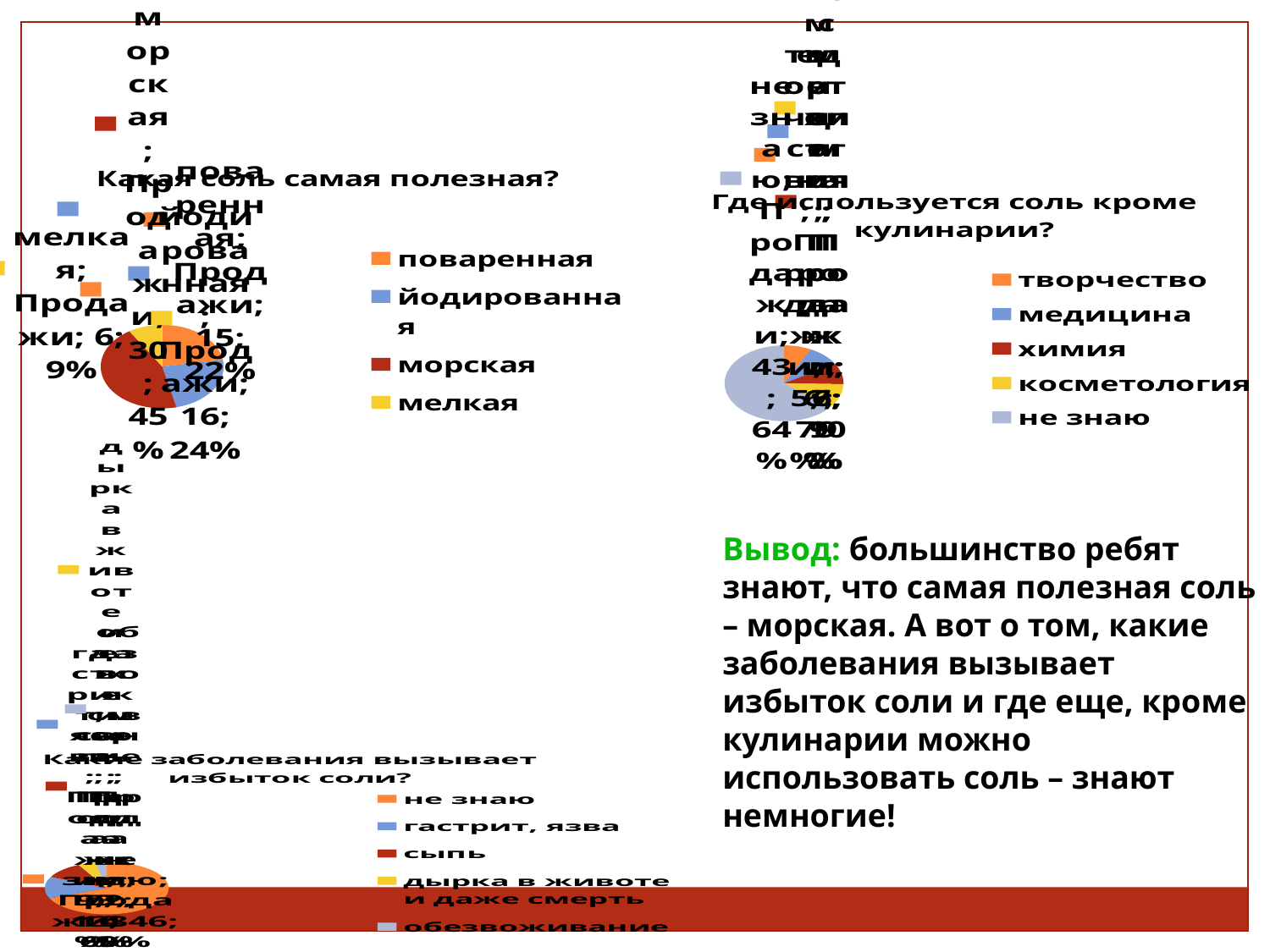
In the chart "Какая соль самая полезная?", what percentage share does "мелкая" have? 9% What kind of chart is used for "Какая соль самая полезная?"? pie chart How many entries does the legend of the chart "Какая соль самая полезная?" list? 4 How many entries does the legend of the chart "Где используется соль кроме кулинарии?" list? 5 In the chart "Где используется соль кроме кулинарии?", what percentage share does "не знаю" have? 64% In the chart "Какая соль самая полезная?", which slice is larger: "морская" or "мелкая"? морская In the chart "Какие заболевания вызывает избыток соли?", which answer has the largest share? не знаю In the chart "Какая соль самая полезная?", what percentage share does "морская" have? 45% What colour represents "морская" in the chart "Какая соль самая полезная?"? dark red In the chart "Какая соль самая полезная?", which type of salt has the largest share? морская In the chart "Где используется соль кроме кулинарии?", which answer has the largest share? не знаю How many entries does the legend of the chart "Какие заболевания вызывает избыток соли?" list? 5